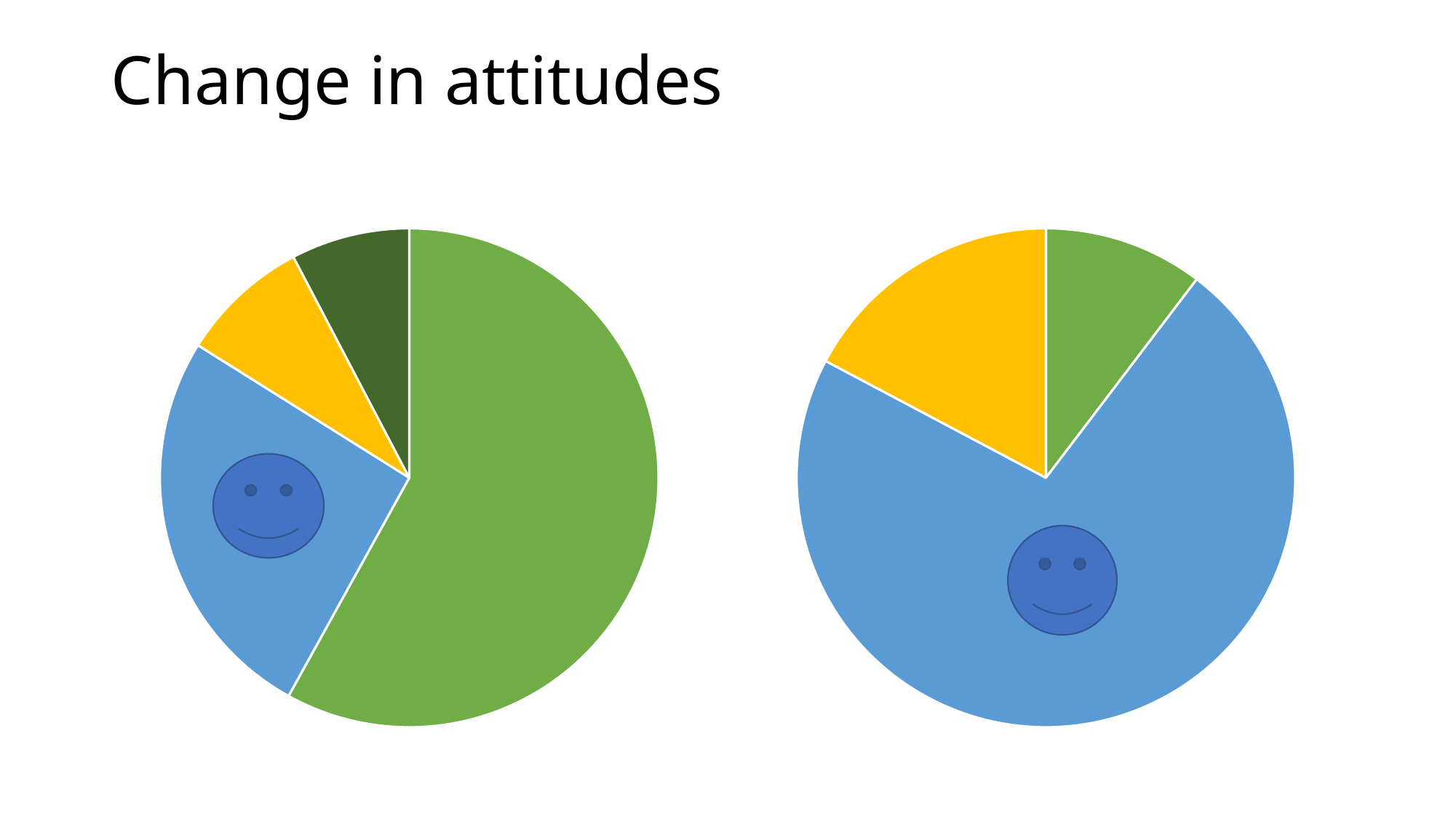
In the right pie chart, is the yellow slice or the green slice larger? yellow Which colour slice contains a smiley face in both pie charts? blue In the left pie chart, is the blue slice or the yellow slice larger? blue What kind of chart is the right chart on the slide? pie chart What is the title of the slide containing the two pie charts? Change in attitudes In the right pie chart, which colour slice is the smallest? green In the left pie chart, which colour slice is the smallest? dark green What kind of chart is the left chart on the slide? pie chart How many slices does the left pie chart have? 4 In the left pie chart, which colour slice is the largest? green How many slices does the right pie chart have? 3 In the right pie chart, which colour slice is the largest? blue